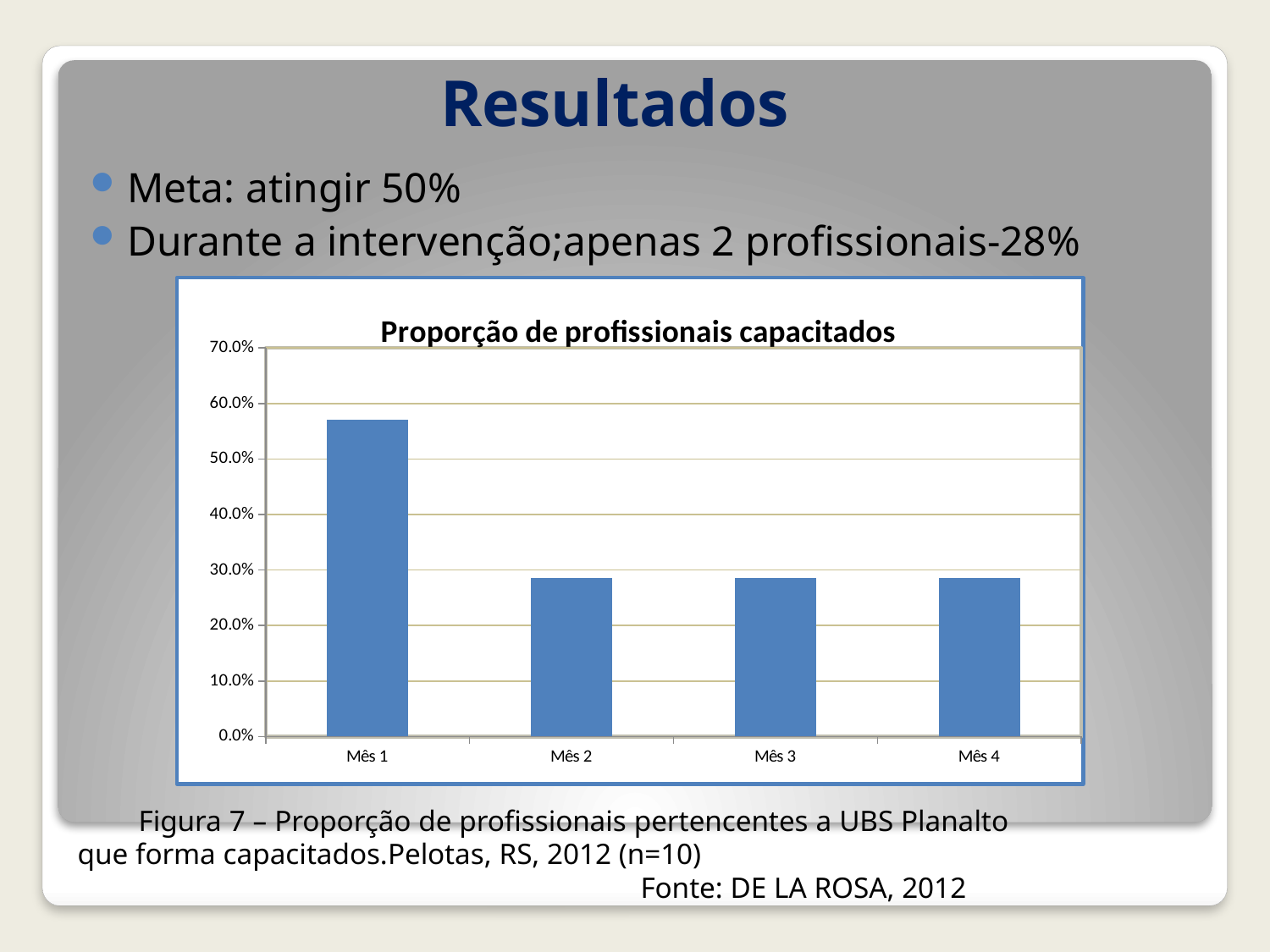
Which month has the highest proportion of trained professionals? Mês 1 What is the title of the chart? Proporção de profissionais capacitados Is the value for Mês 1 greater or less than 50.0%? greater Which is larger, the value for Mês 1 or the value for Mês 2? Mês 1 How many categories (months) are plotted on the x axis? 4 Does the value rise or fall from Mês 1 to Mês 2? fall Is the value for Mês 2 greater or less than 30.0%? less Is the value for Mês 4 greater or less than 40.0%? less What type of chart is shown on the slide? bar chart Which is larger, the value for Mês 4 or the value for Mês 1? Mês 1